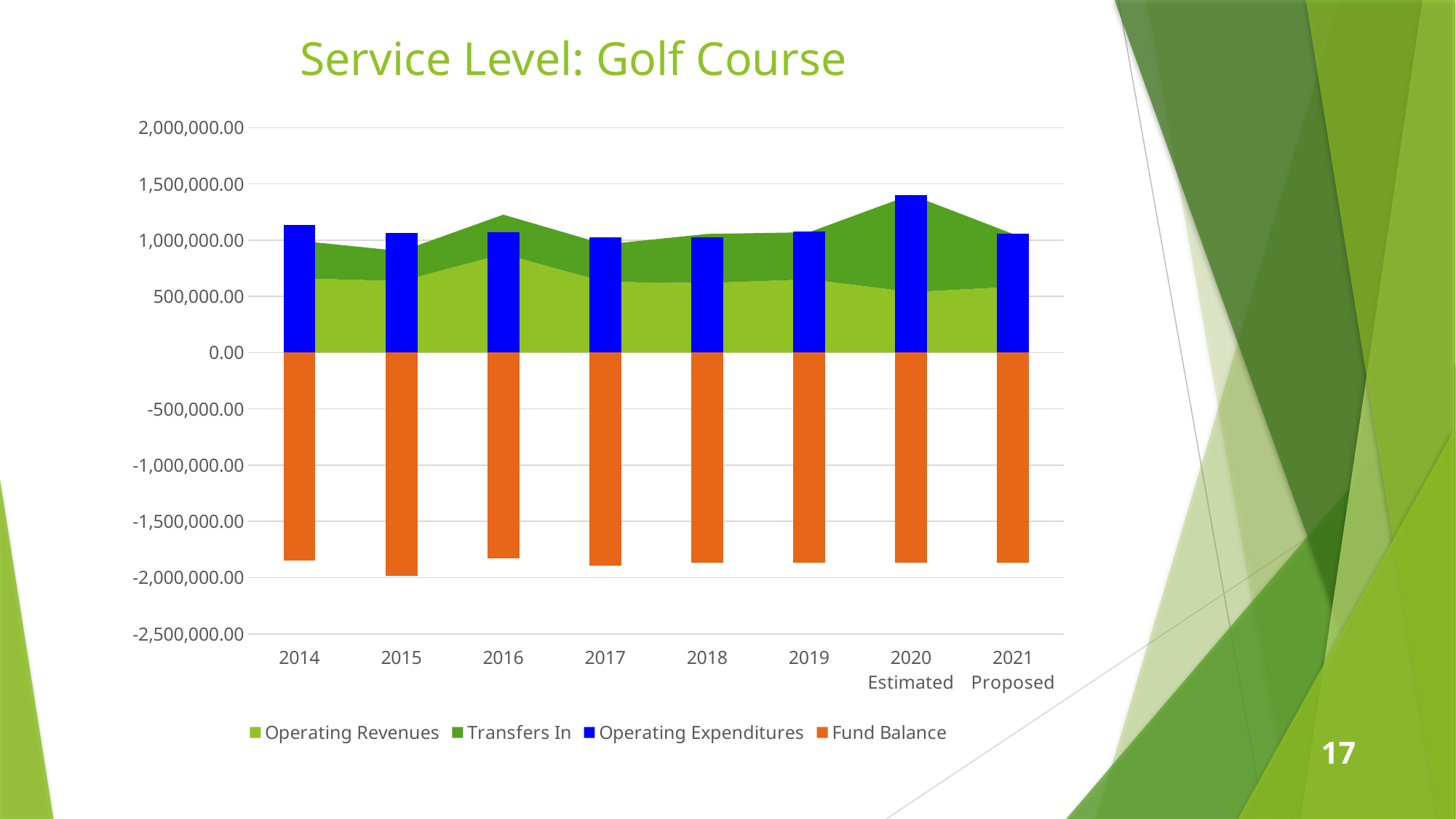
Is the Operating Expenditures value for 2014 greater or less than 1,000,000.00? greater Is the Fund Balance value for 2015 greater or less than -1,500,000.00? less Is the Operating Expenditures value for 2020 Estimated greater or less than 1,500,000.00? less What is the title of the chart? Service Level: Golf Course Which is larger, Operating Expenditures in 2014 or in 2020 Estimated? 2020 Estimated How many series does the legend list? 4 How many years (categories) are shown on the x axis? 8 In which year does the Fund Balance bar reach its lowest (most negative) value? 2015 What kind of chart is this? A combination bar and area chart Which series is shown in orange in the legend? Fund Balance In which year is the Operating Expenditures bar the highest? 2020 Estimated